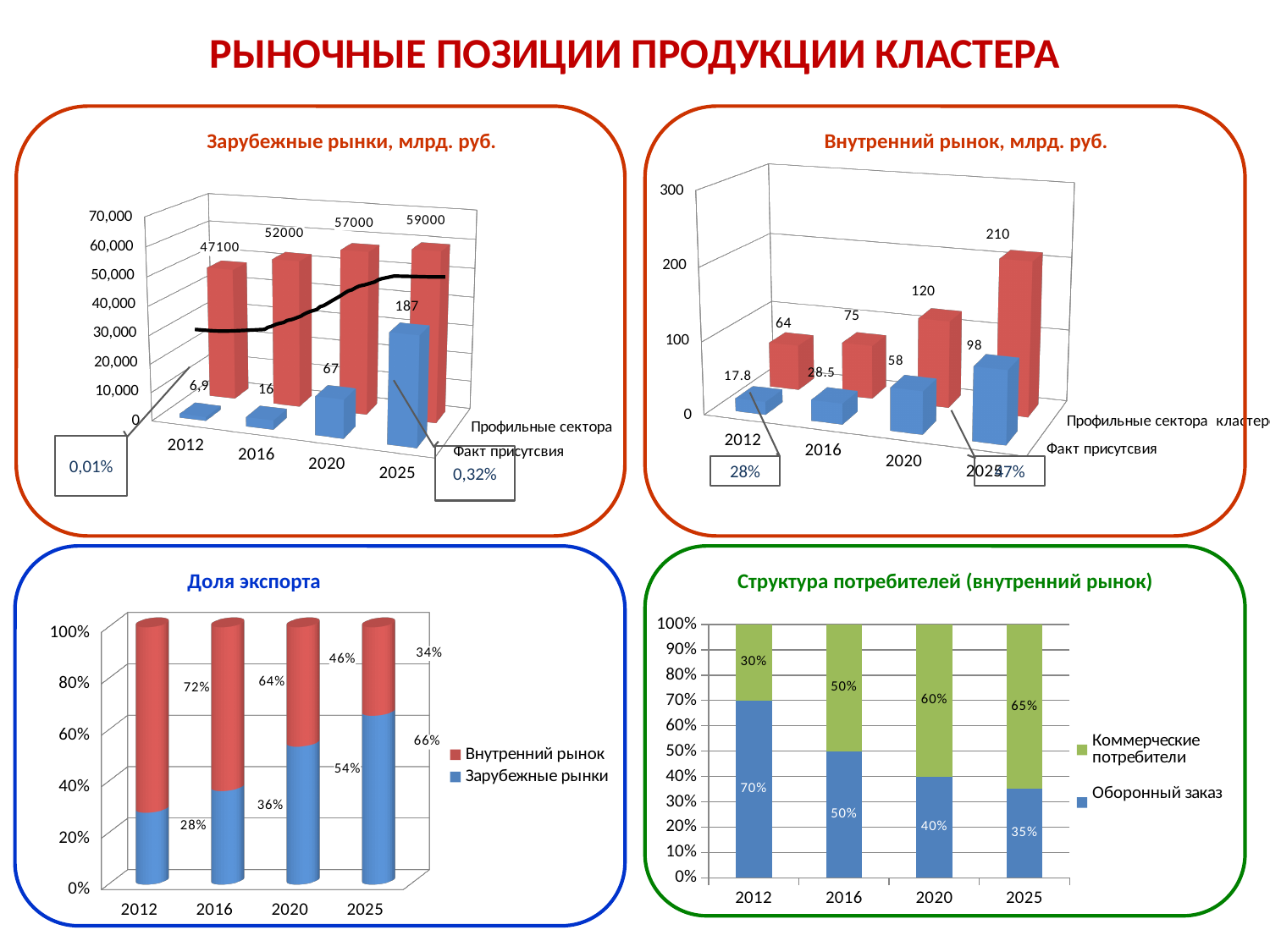
In the chart 'Доля экспорта', what is the share of Зарубежные рынки in 2020? 54% In the chart 'Зарубежные рынки, млрд. руб.', what is the value of the blue bar (Факт присутсвия) for 2025? 187 In the chart 'Внутренний рынок, млрд. руб.', what is the value of the red bar (Профильные сектора кластера) for 2025? 210 In the chart 'Внутренний рынок, млрд. руб.', what is the value of the blue bar (Факт присутсвия) for 2012? 17.8 In the chart 'Структура потребителей (внутренний рынок)', how many series does the legend list? 2 How many years are shown on the x axis of the chart 'Доля экспорта'? 4 In the chart 'Доля экспорта', does the share of Зарубежные рынки rise or fall from 2012 to 2025? rise In the chart 'Структура потребителей (внутренний рынок)', which is larger in 2016: Коммерческие потребители or Оборонный заказ? They are equal (50% each) In the chart 'Структура потребителей (внутренний рынок)', what is the share of Оборонный заказ in 2025? 35% In the chart 'Зарубежные рынки, млрд. руб.', which year has the highest red bar (Профильные сектора)? 2025 What kind of chart is 'Доля экспорта'? Stacked bar chart In the chart 'Внутренний рынок, млрд. руб.', what is the difference between the red bar and the blue bar for 2020? 62